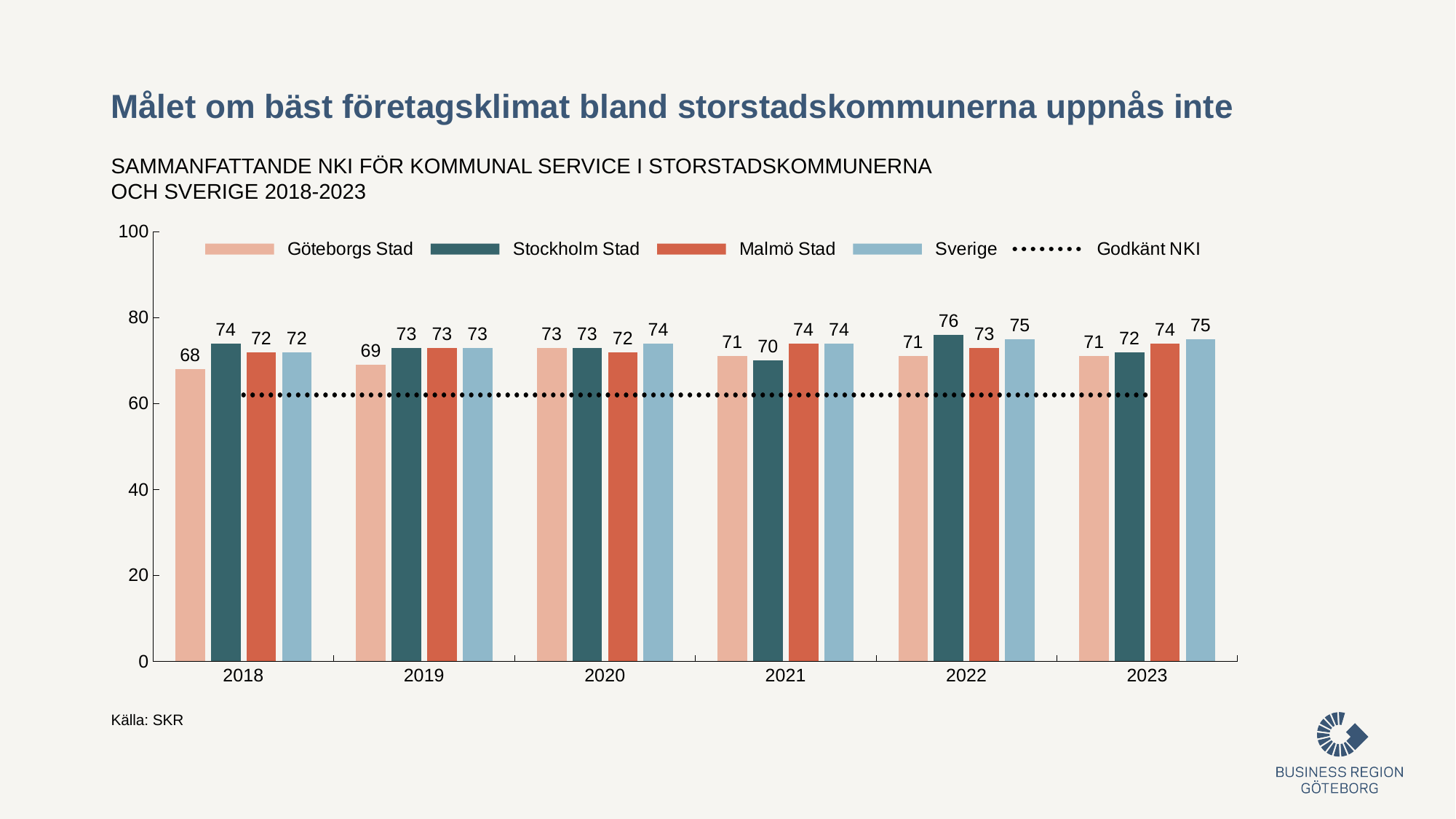
What is the NKI value for Sverige in 2023? 75 Which series has the highest value in 2022? Stockholm Stad Which series has the lowest value in 2021? Stockholm Stad How many years are shown on the x axis? 6 How many entries does the legend list? 5 What is the NKI value for Malmö Stad in 2021? 74 Does the value for Göteborgs Stad rise or fall from 2018 to 2020? Rise Which is larger in 2023: the value for Göteborgs Stad or the value for Sverige? Sverige What kind of chart is shown on the slide? Bar chart What is the NKI value for Göteborgs Stad in 2018? 68 What is the NKI value for Stockholm Stad in 2022? 76 What is the difference between the Stockholm Stad and Göteborgs Stad values in 2018? 6